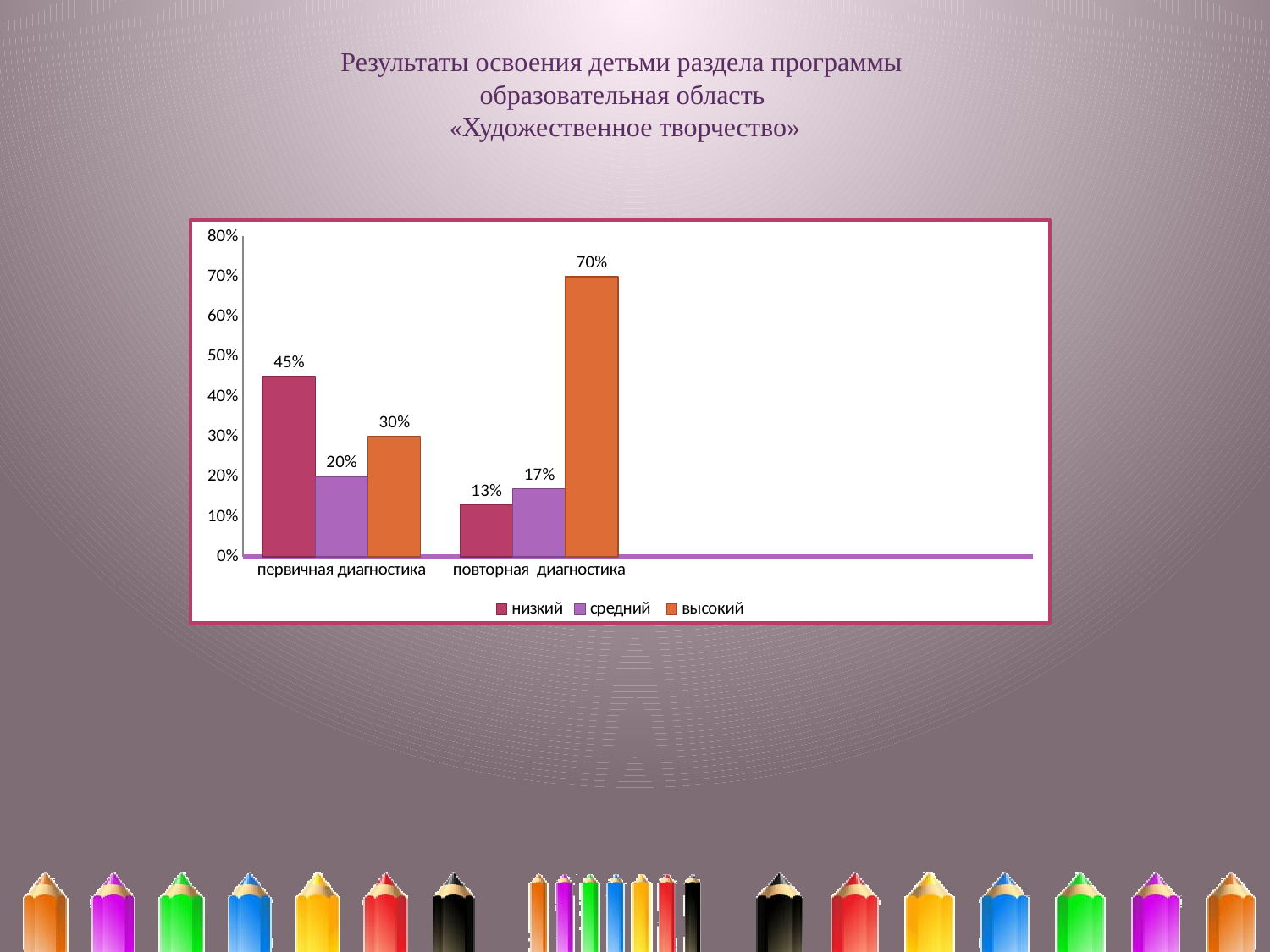
What is the value for высокий at первичная диагностика? 30% What is the difference between высокий at повторная диагностика and высокий at первичная диагностика? 40% How many series does the legend list? 3 What kind of chart is shown on the slide? bar chart What is the value for низкий at первичная диагностика? 45% Which series has the lowest value at повторная диагностика? низкий What colour are the bars for the series высокий? orange What is the value for высокий at повторная диагностика? 70% Which is larger: низкий at первичная диагностика or низкий at повторная диагностика? первичная диагностика What is the value for средний at повторная диагностика? 17% Which series has the highest value at повторная диагностика? высокий How many categories are shown on the x axis? 2